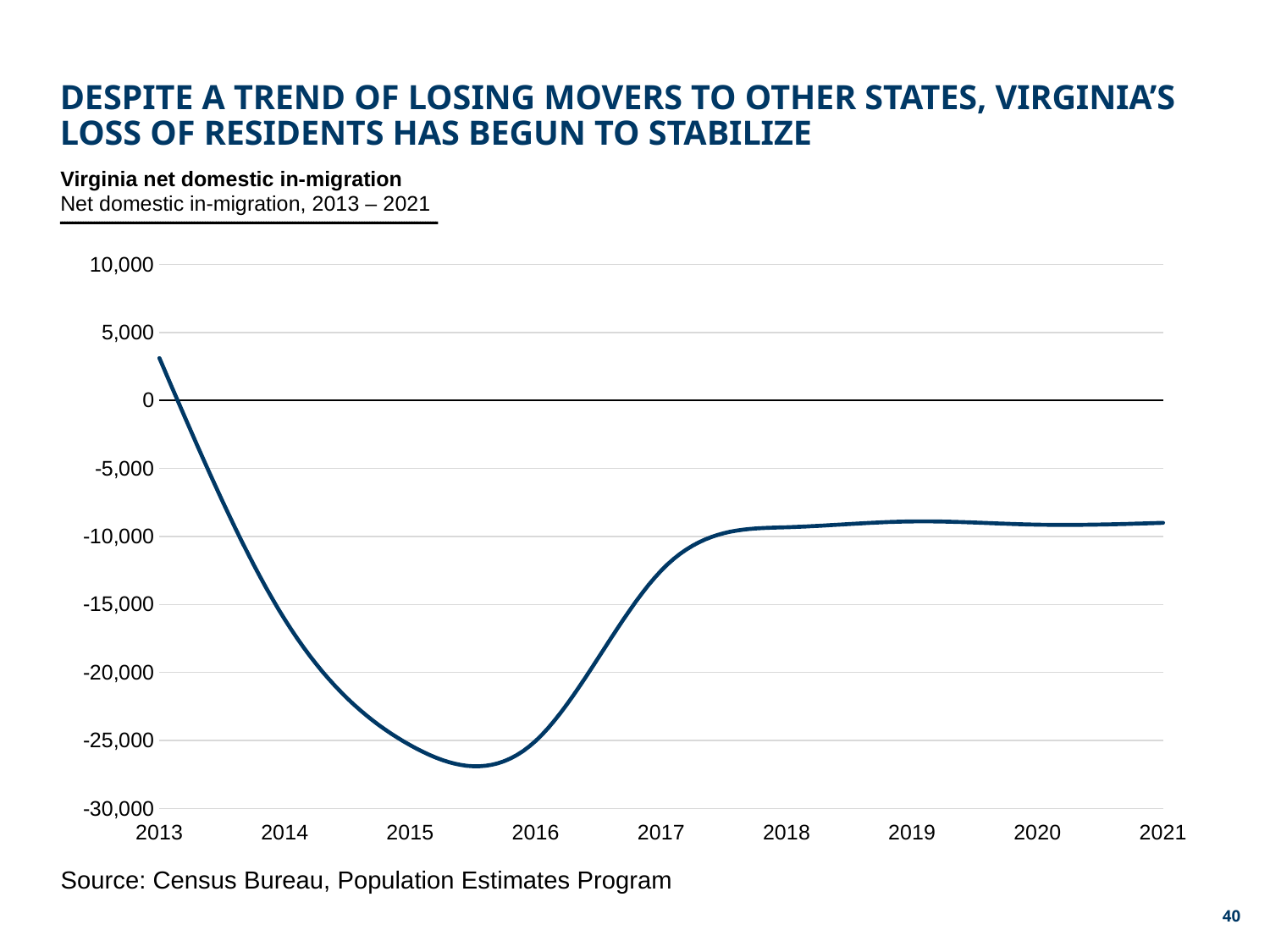
Which year has the larger value, 2014 or 2018? 2018 What kind of chart is shown on the slide? line chart Does the line rise or fall between 2013 and 2015? fall Is the value for 2016 greater or less than -20,000? less Is the value for 2013 greater or less than 0? greater Which year has the highest net domestic in-migration value on the chart? 2013 How many years are labeled on the x axis of the chart? 9 Is the value for 2019 greater or less than -10,000? greater What is the title of the chart? Virginia net domestic in-migration